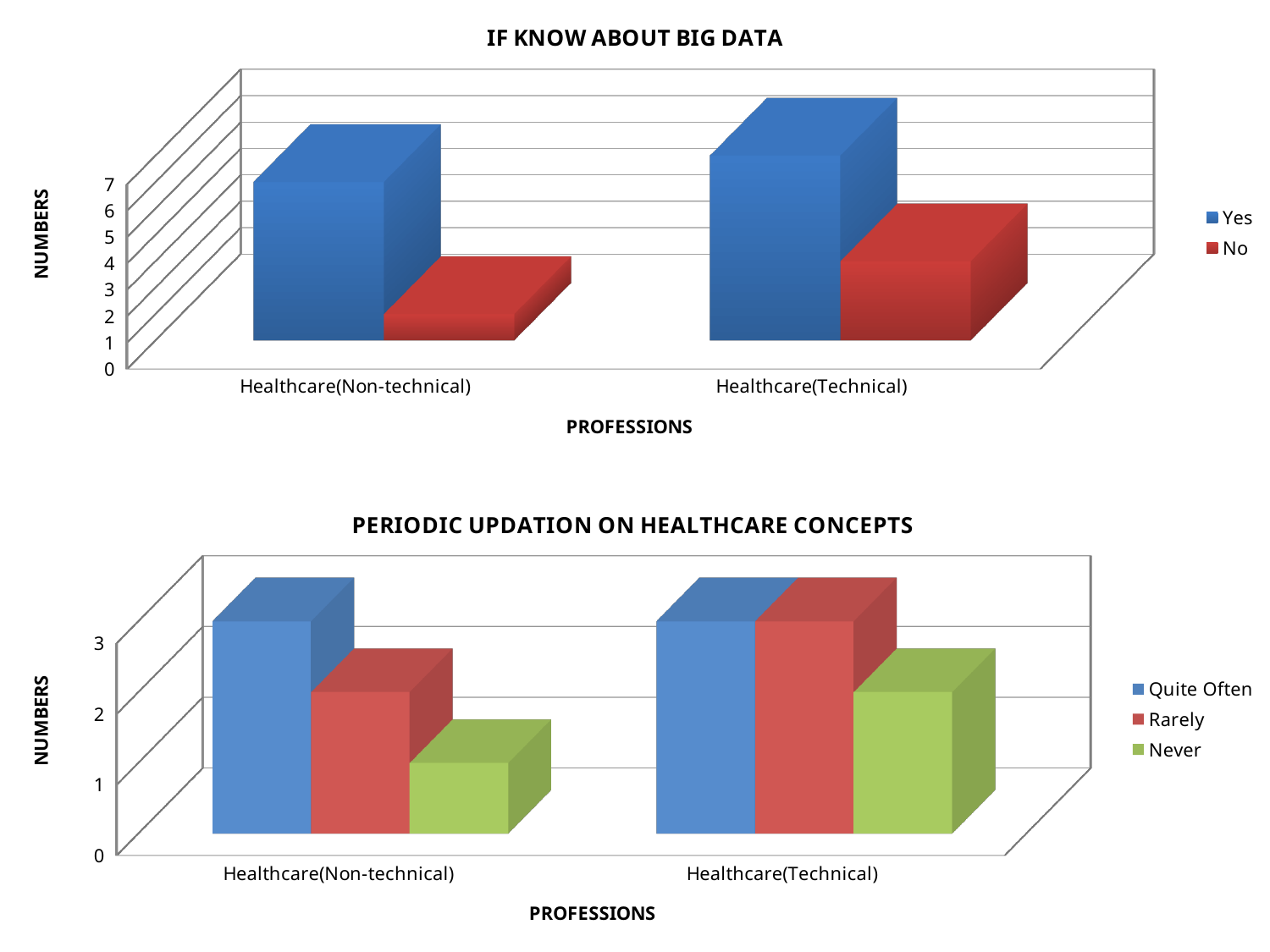
In the top chart 'IF KNOW ABOUT BIG DATA', which is larger for Healthcare(Non-technical): Yes or No? Yes What kind of chart is the top chart titled 'IF KNOW ABOUT BIG DATA'? Bar chart In the bottom chart 'PERIODIC UPDATION ON HEALTHCARE CONCEPTS', which series has the lowest value for Healthcare(Non-technical)? Never In the top chart 'IF KNOW ABOUT BIG DATA', how many series does the legend list? 2 In the bottom chart 'PERIODIC UPDATION ON HEALTHCARE CONCEPTS', is the Never value for Healthcare(Non-technical) greater or less than 2? less In the top chart 'IF KNOW ABOUT BIG DATA', is the Yes value for Healthcare(Non-technical) greater or less than 4? greater In the top chart 'IF KNOW ABOUT BIG DATA', how many profession categories are shown on the x axis? 2 In the bottom chart 'PERIODIC UPDATION ON HEALTHCARE CONCEPTS', which series has the highest value for Healthcare(Non-technical)? Quite Often In the top chart 'IF KNOW ABOUT BIG DATA', is the No value for Healthcare(Non-technical) greater or less than 4? less What is the label of the vertical axis on the bottom chart 'PERIODIC UPDATION ON HEALTHCARE CONCEPTS'? NUMBERS In the bottom chart 'PERIODIC UPDATION ON HEALTHCARE CONCEPTS', how many series does the legend list? 3 In the top chart 'IF KNOW ABOUT BIG DATA', is the Yes value for Healthcare(Technical) larger or smaller than the Yes value for Healthcare(Non-technical)? Larger